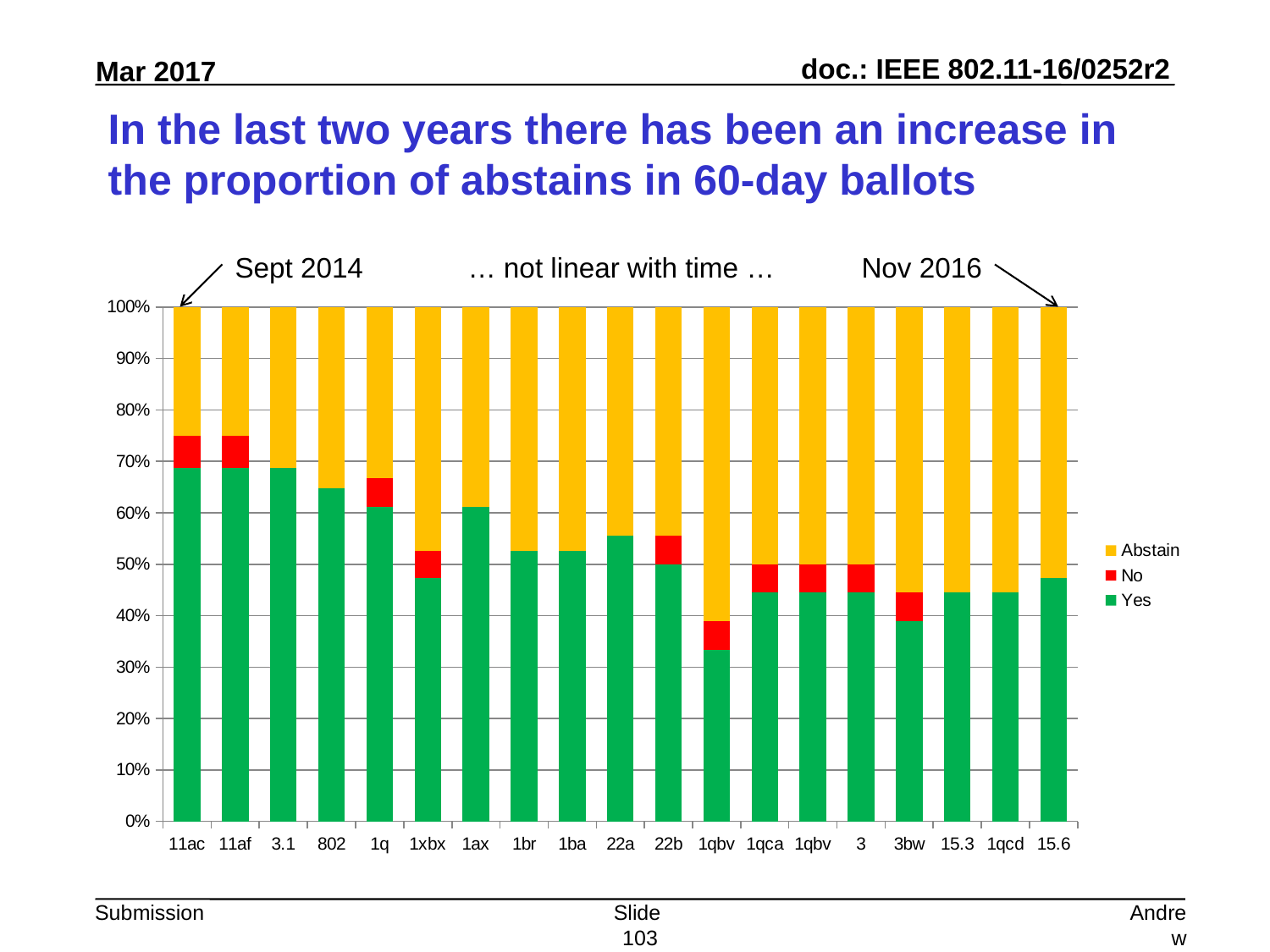
Which has the larger Yes share, 11ac or 1qca? 11ac What kind of chart is shown on the slide? Stacked bar chart How many categories are shown along the x axis? 19 Does the Yes share generally rise or fall from left to right along the x axis? fall Which has the larger Abstain share, 15.6 or 11af? 15.6 Is the Abstain share for 11ac greater or less than 30%? less How many series does the legend list? 3 Is the Yes share for 15.6 greater or less than 50%? less Which colour represents the Abstain series in the legend? Yellow Is the Yes share for 11ac greater or less than 60%? greater Which category has the lowest Yes share? 1qbv